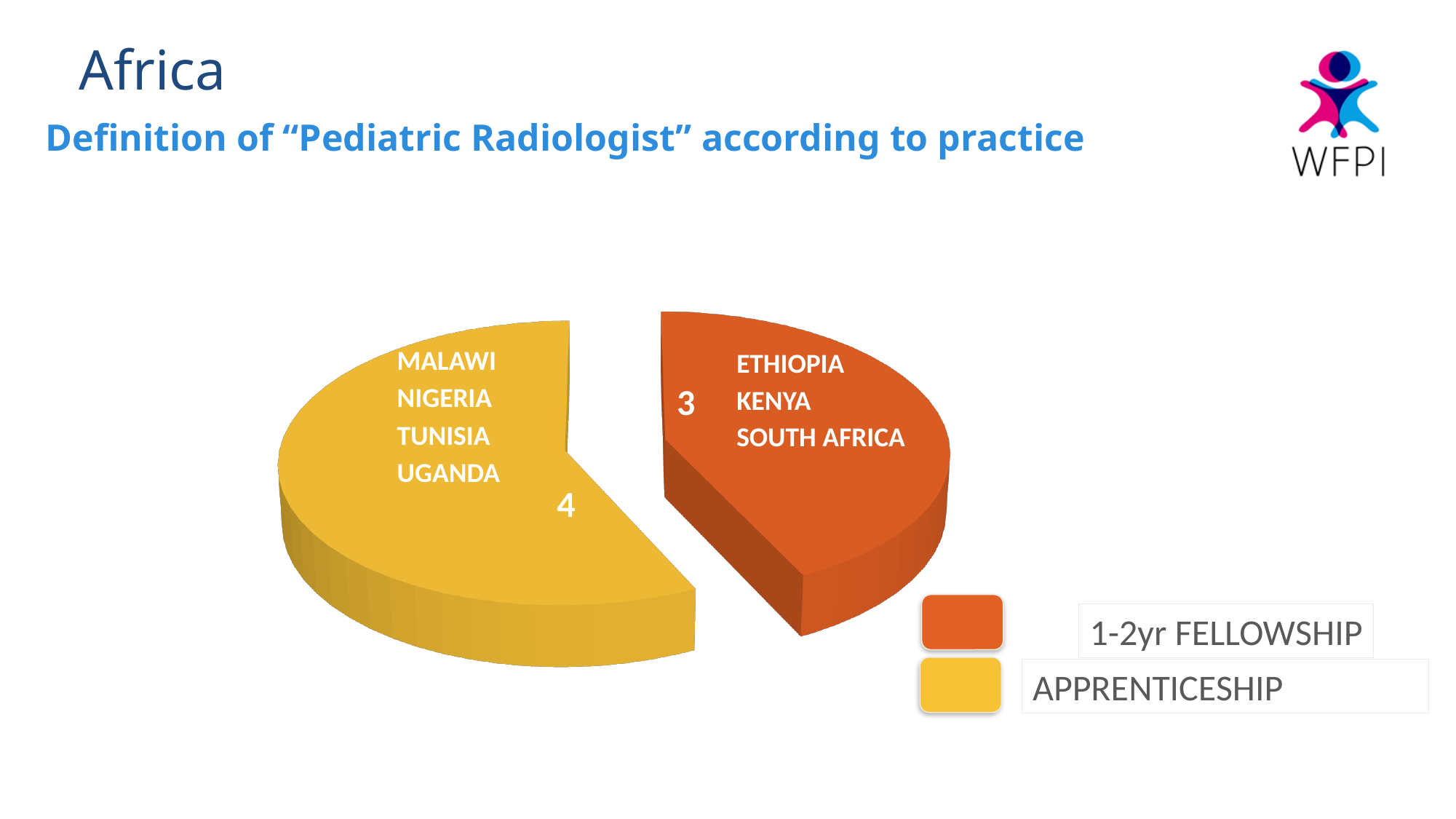
What is the value of the APPRENTICESHIP slice? 4 What kind of chart is shown on the slide? pie chart What colour is the APPRENTICESHIP slice? yellow Which slice is the smallest? 1-2yr FELLOWSHIP Which slice is the largest? APPRENTICESHIP How many entries does the legend list? 2 Which is larger, APPRENTICESHIP or 1-2yr FELLOWSHIP? APPRENTICESHIP How many slices does the pie chart have? 2 What is the difference between the APPRENTICESHIP and 1-2yr FELLOWSHIP values? 1 What is the value of the 1-2yr FELLOWSHIP slice? 3 What is the total of all slices in the pie chart? 7 Which countries are listed in the 1-2yr FELLOWSHIP slice? ETHIOPIA, KENYA, SOUTH AFRICA